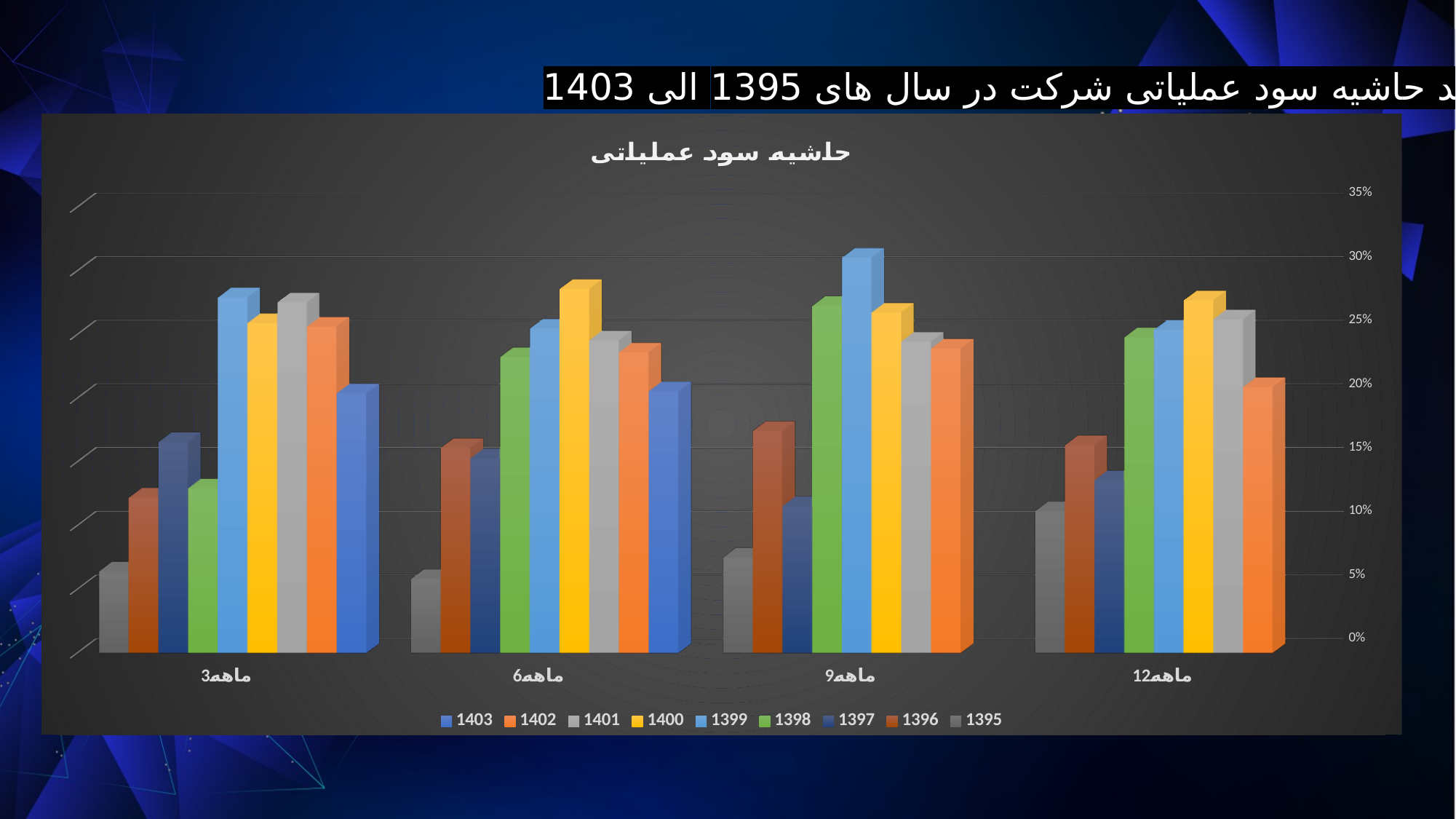
Which series has the lowest value in the 3ماهه category? 1395 Is the value for 1399 in the 9ماهه category greater or less than 25%? greater How many series does the chart legend list? 9 How many categories are shown on the x axis of the chart? 4 In the 12ماهه category, which is larger: the value for 1398 or the value for 1396? 1398 Is the value for 1397 in the 9ماهه category greater or less than 15%? less Is the value for 1395 in the 3ماهه category greater or less than 10%? less Which series has the highest value in the 9ماهه category? 1399 What kind of chart is shown on the slide? bar chart Which series has the highest value in the 6ماهه category? 1400 What is the title of the chart? حاشیه سود عملیاتی In the 9ماهه category, which is larger: the value for 1399 or the value for 1397? 1399